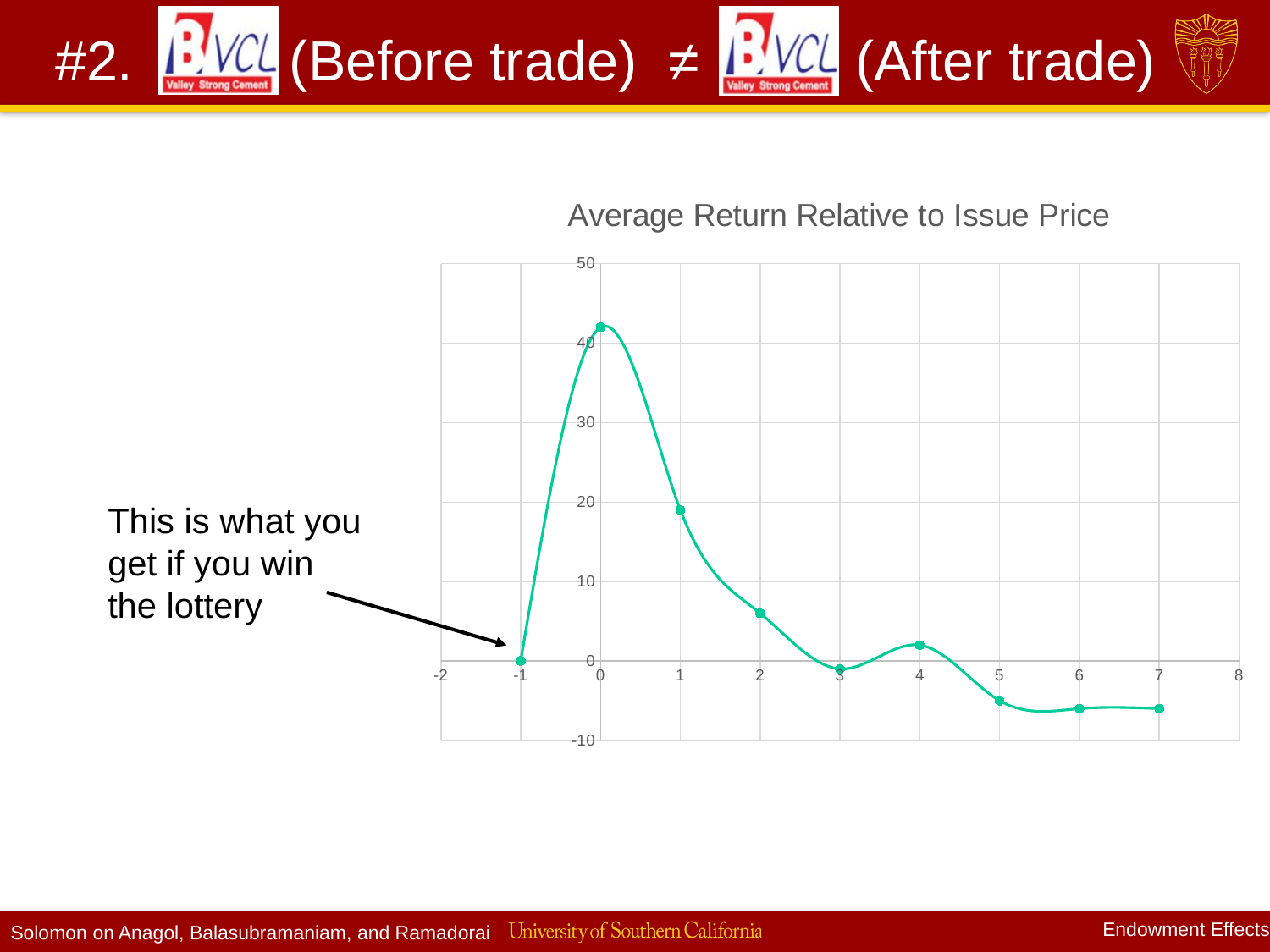
Is the value at x = 5 greater or less than 0? less How many data points are plotted on the line? 9 At which x value does the line reach its highest point? 0 What is the title of the chart? Average Return Relative to Issue Price Which has the larger value, x = 0 or x = 1? x = 0 Is the value at x = 1 greater or less than 10? greater What is the value plotted at x = -1? 0 Do the values rise or fall as x goes from 0 to 3? fall Is the value at x = 2 greater or less than 10? less What is the highest value shown on the vertical axis? 50 What kind of chart is shown on the slide? line chart